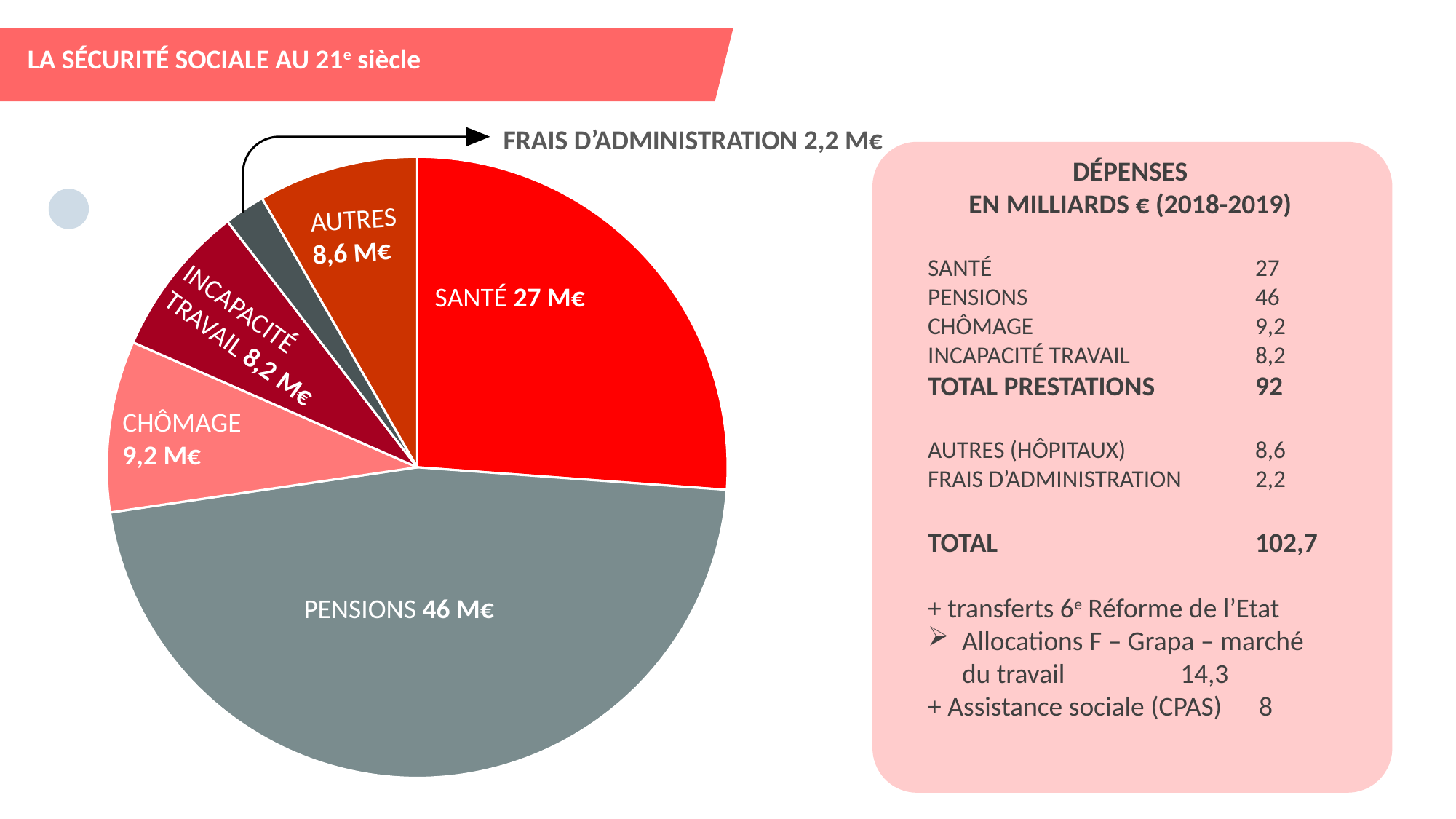
Which is larger in the pie chart, AUTRES or INCAPACITÉ TRAVAIL? AUTRES Which slice of the pie chart is the largest? PENSIONS What value is shown for the CHÔMAGE slice of the pie chart? 9,2 M€ What is the difference between the PENSIONS value and the SANTÉ value in the pie chart? 19 M€ What value is shown for the PENSIONS slice of the pie chart? 46 M€ Which slice of the pie chart is the smallest? FRAIS D'ADMINISTRATION What is the total of all the slices in the pie chart, as given in the table on the right? 102,7 What value is labelled for FRAIS D'ADMINISTRATION on the pie chart? 2,2 M€ What kind of chart is shown on the slide? Pie chart How many slices does the pie chart have? 6 What colour is the PENSIONS slice of the pie chart? Grey What value is shown for the SANTÉ slice of the pie chart? 27 M€